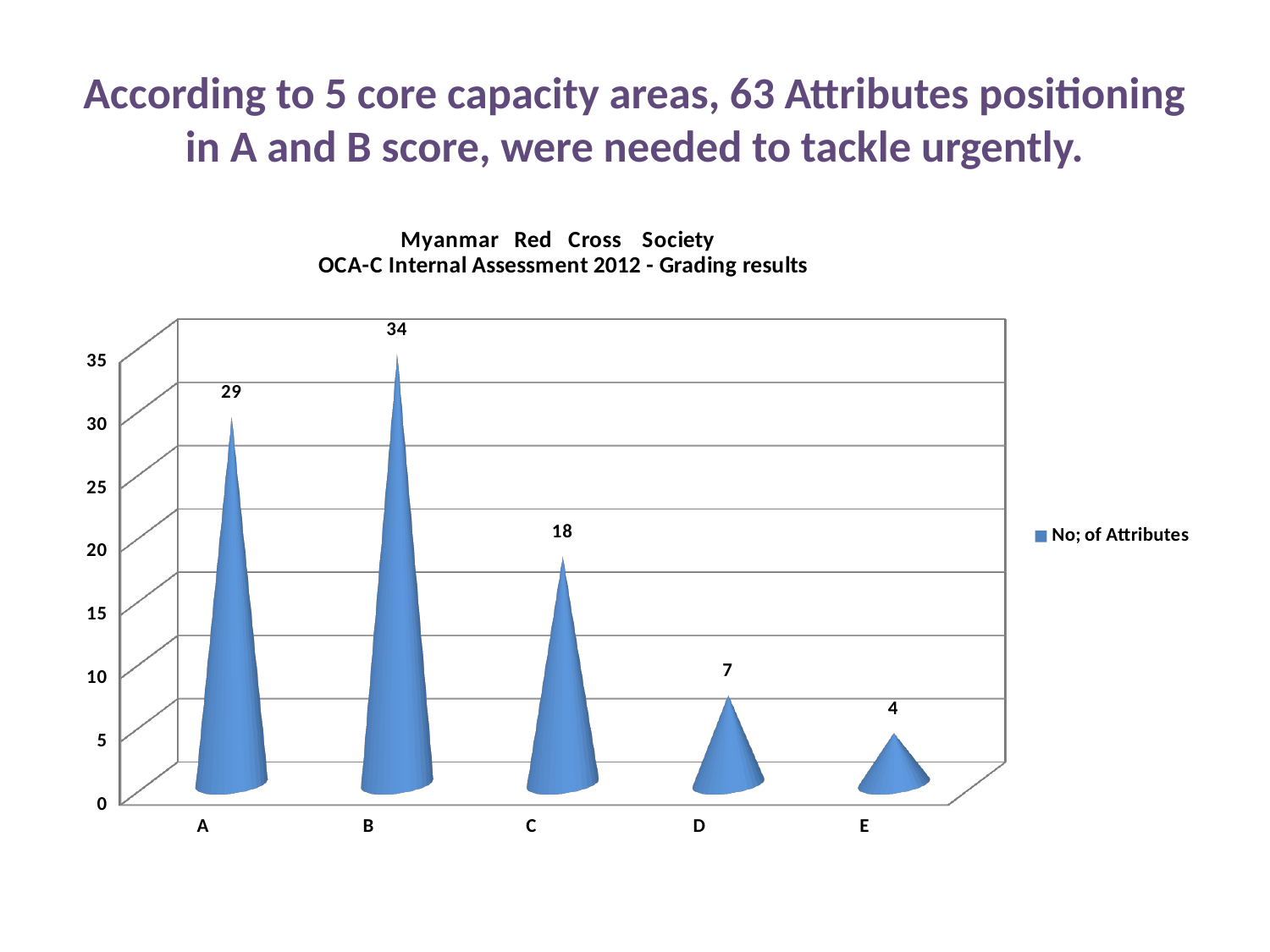
Which category has the lowest number of attributes? E Which has more attributes, category A or category C? A How many categories are shown on the x axis? 5 How many series does the legend list? 1 What is the difference between the number of attributes for A and for B? 5 What is the number of attributes for category E? 4 What is the legend entry for the plotted series? No; of Attributes What is the number of attributes for category C? 18 What is the difference between the number of attributes for C and for D? 11 Which category has the highest number of attributes? B What is the number of attributes for category B? 34 Is the value for category D greater or less than 10? less